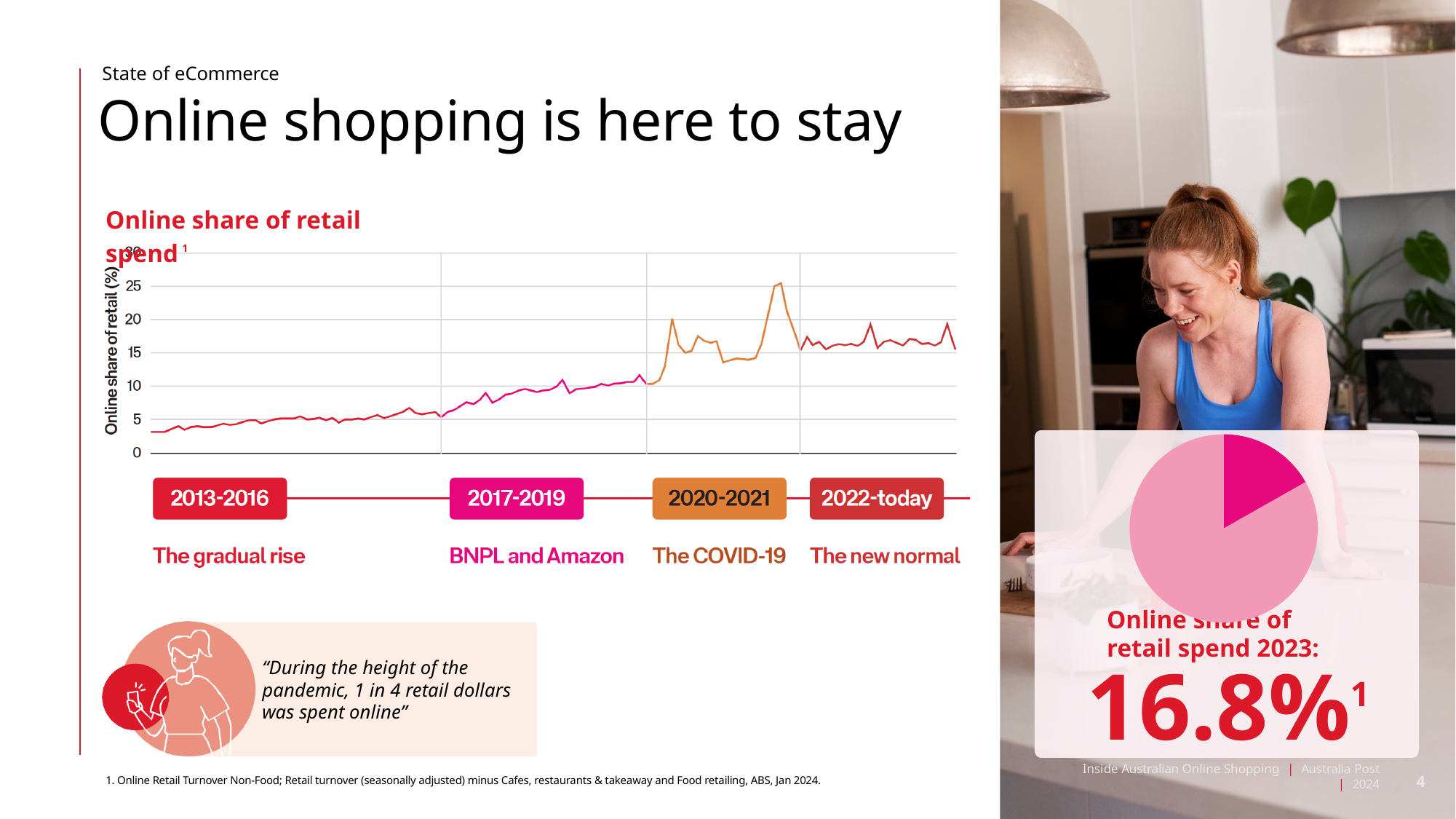
In the pie chart on the right of the slide, what is the online share of retail spend in 2023? 16.8% What kind of chart is shown on the right of the slide with the 'Online share of retail spend 2023' label? pie chart In the 'Online share of retail spend' chart, what is the highest tick value shown on the y axis? 30 In the 'Online share of retail spend' chart, which period contains the highest value of the line? 2020-2021 In the 'Online share of retail spend' chart, is the peak value during the 2020-2021 period greater or less than 20? greater In the 'Online share of retail spend' chart, does the online share generally rise or fall from 2013 to 2019? rise What kind of chart is the 'Online share of retail spend' chart? line chart In the 'Online share of retail spend' chart, which period is labelled 'The COVID-19'? 2020-2021 How many time periods are labelled below the 'Online share of retail spend' chart? 4 In the 'Online share of retail spend' chart, is the value at the start of the 2013-2016 period greater or less than 5? less In the 'Online share of retail spend' chart, are the values in the 2022-today period greater or less than 10? greater